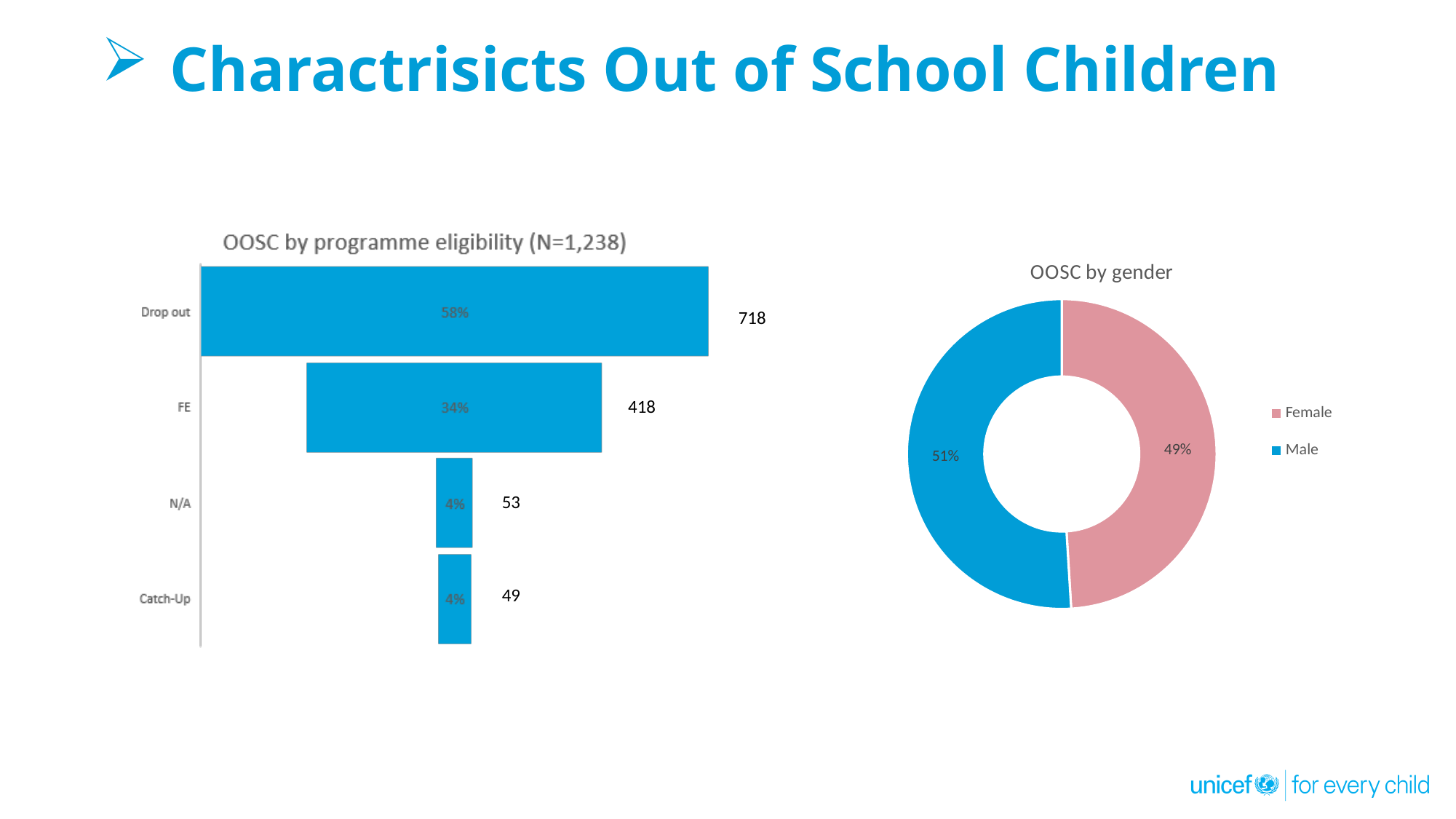
In the 'OOSC by programme eligibility (N=1,238)' chart, which has a larger count, N/A or Catch-Up? N/A In the 'OOSC by gender' chart, what share is Female? 49% In the 'OOSC by programme eligibility (N=1,238)' chart, what is the difference between the Drop out count and the FE count? 300 In the 'OOSC by programme eligibility (N=1,238)' chart, what percentage is shown for FE? 34% In the 'OOSC by programme eligibility (N=1,238)' chart, what is the count for Drop out? 718 How many entries does the legend of the 'OOSC by gender' chart list? 2 In the 'OOSC by gender' chart, which colour represents Female? Pink What kind of chart is the 'OOSC by programme eligibility (N=1,238)' chart? Bar chart In the 'OOSC by programme eligibility (N=1,238)' chart, which category has the highest count? Drop out How many categories are shown in the 'OOSC by programme eligibility (N=1,238)' chart? 4 In the 'OOSC by programme eligibility (N=1,238)' chart, what is the count for Catch-Up? 49 In the 'OOSC by gender' chart, what share is Male? 51%